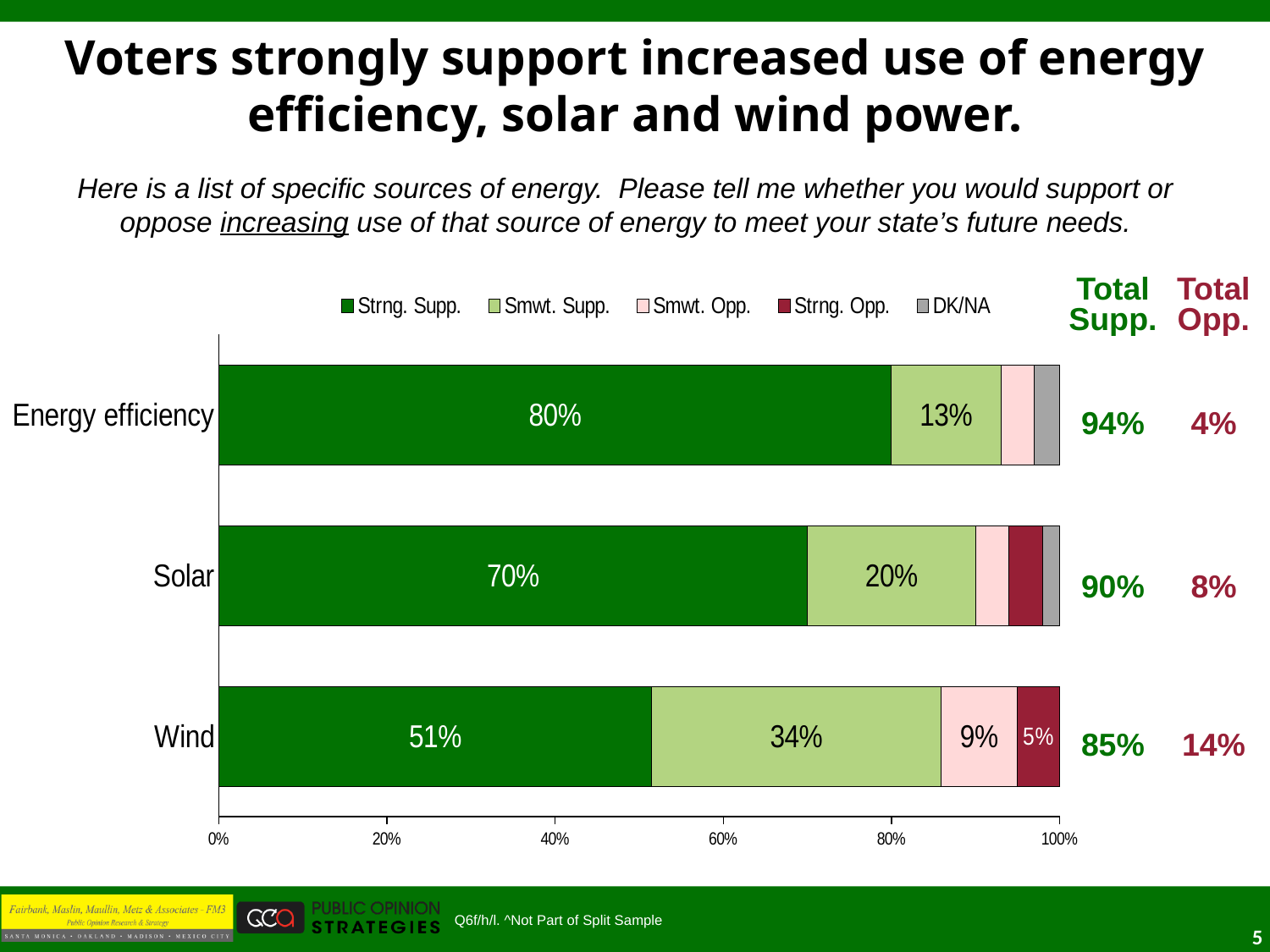
How many energy sources are shown in the chart? 3 Which energy source has the highest Strng. Supp. value? Energy efficiency What is the Smwt. Opp. value for Wind? 9% Which energy source has the lowest Strng. Supp. value? Wind What kind of chart is shown on the slide? Stacked bar chart What is the Strng. Opp. value for Wind? 5% What is the Total Supp. value shown for Wind? 85% What is the Strng. Supp. value for Energy efficiency? 80% Is the Smwt. Supp. value larger for Wind or for Solar? Wind What is the difference between the Strng. Supp. values for Energy efficiency and Solar? 10% What is the Smwt. Supp. value for Solar? 20% How many series does the legend list? 5